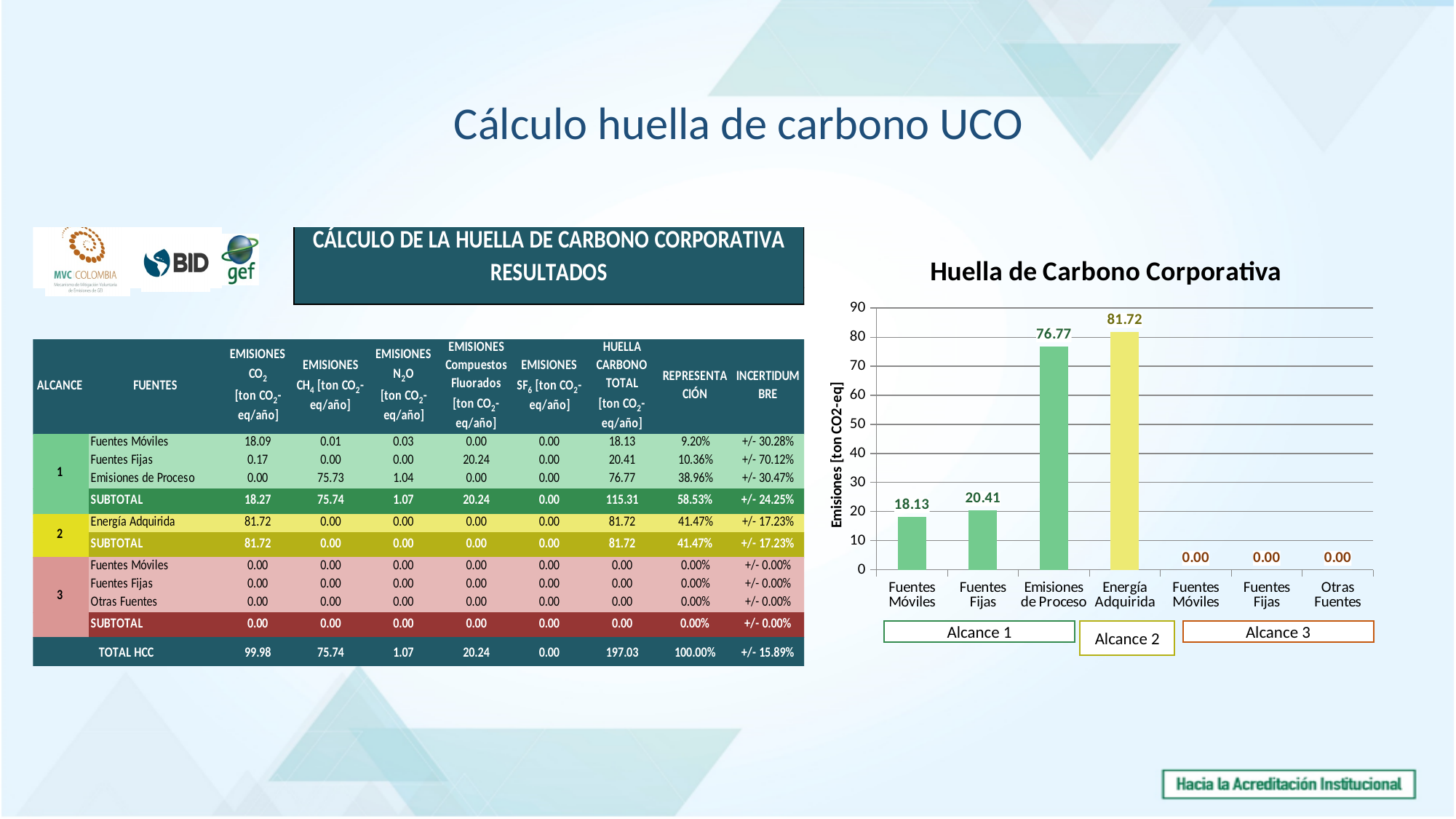
What is the value for Energía Adquirida in the chart? 81.72 What is the value for Fuentes Fijas under Alcance 1 in the chart? 20.41 What is the chart's title? Huella de Carbono Corporativa Which category has the highest value in the chart? Energía Adquirida Which is larger, the value for Fuentes Fijas under Alcance 1 or Fuentes Móviles under Alcance 1? Fuentes Fijas What is the label of the y axis of the chart? Emisiones [ton CO2-eq] What is the value for Emisiones de Proceso in the chart? 76.77 What is the value for Otras Fuentes in the chart? 0.00 What is the value for Fuentes Móviles under Alcance 1 in the chart? 18.13 What type of chart is shown on the slide? Bar chart What is the difference between the values for Energía Adquirida and Emisiones de Proceso? 4.95 How many categories are shown on the x axis of the chart? 7